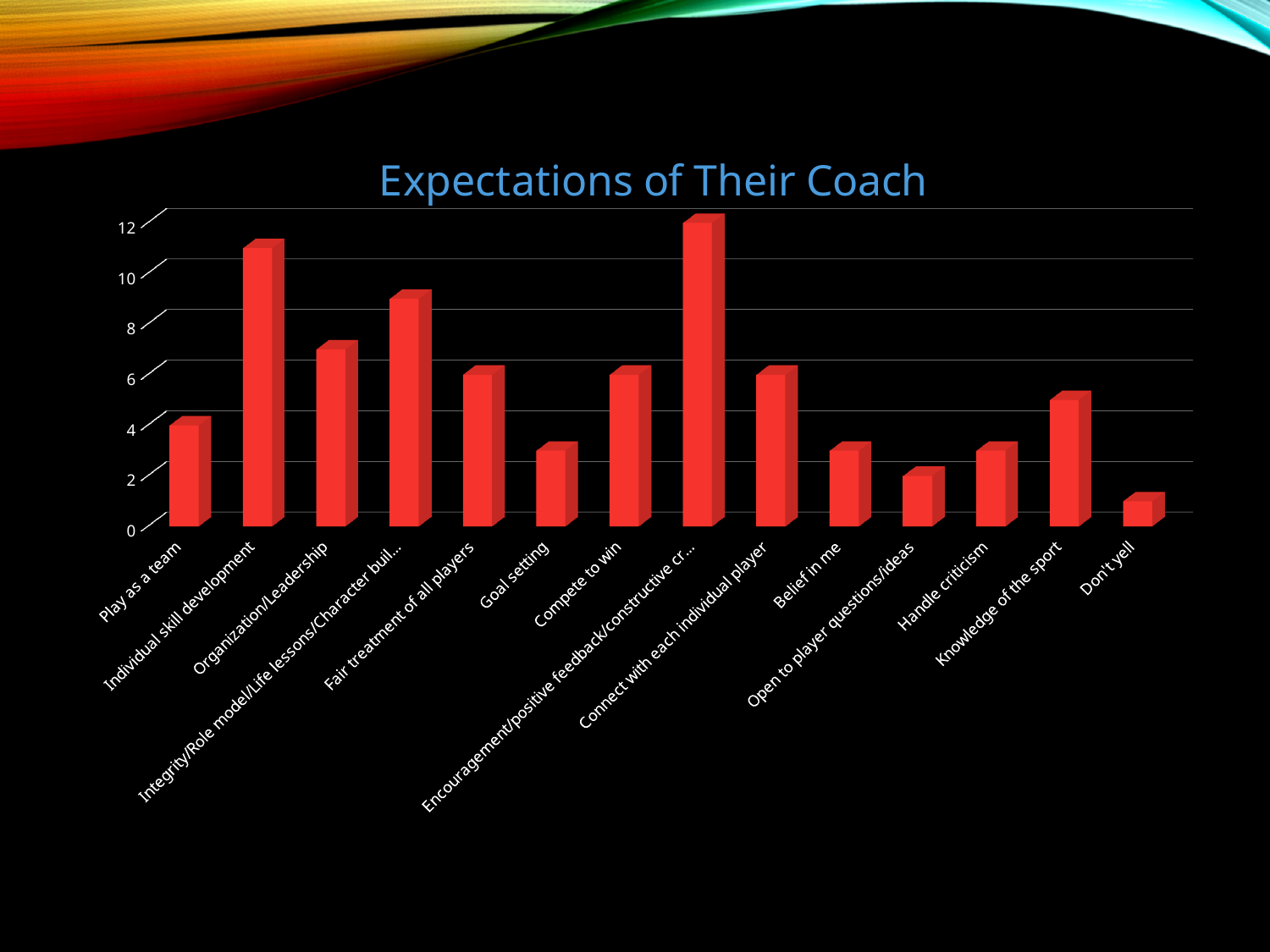
Which category has the highest value? Encouragement/positive feedback/constructive cr... Is the value for Goal setting greater or less than 4? less What colour are the bars in the chart? red Which is larger, the value for Individual skill development or the value for Organization/Leadership? Individual skill development How many categories are plotted on the chart? 14 What is the title of the chart? Expectations of Their Coach Which is larger, the value for Knowledge of the sport or the value for Handle criticism? Knowledge of the sport Is the value for Integrity/Role model/Life lessons/Character buil... greater or less than 8? greater Is the value for Individual skill development greater or less than 10? greater What kind of chart is shown on the slide? bar chart Which category has the lowest value? Don't yell